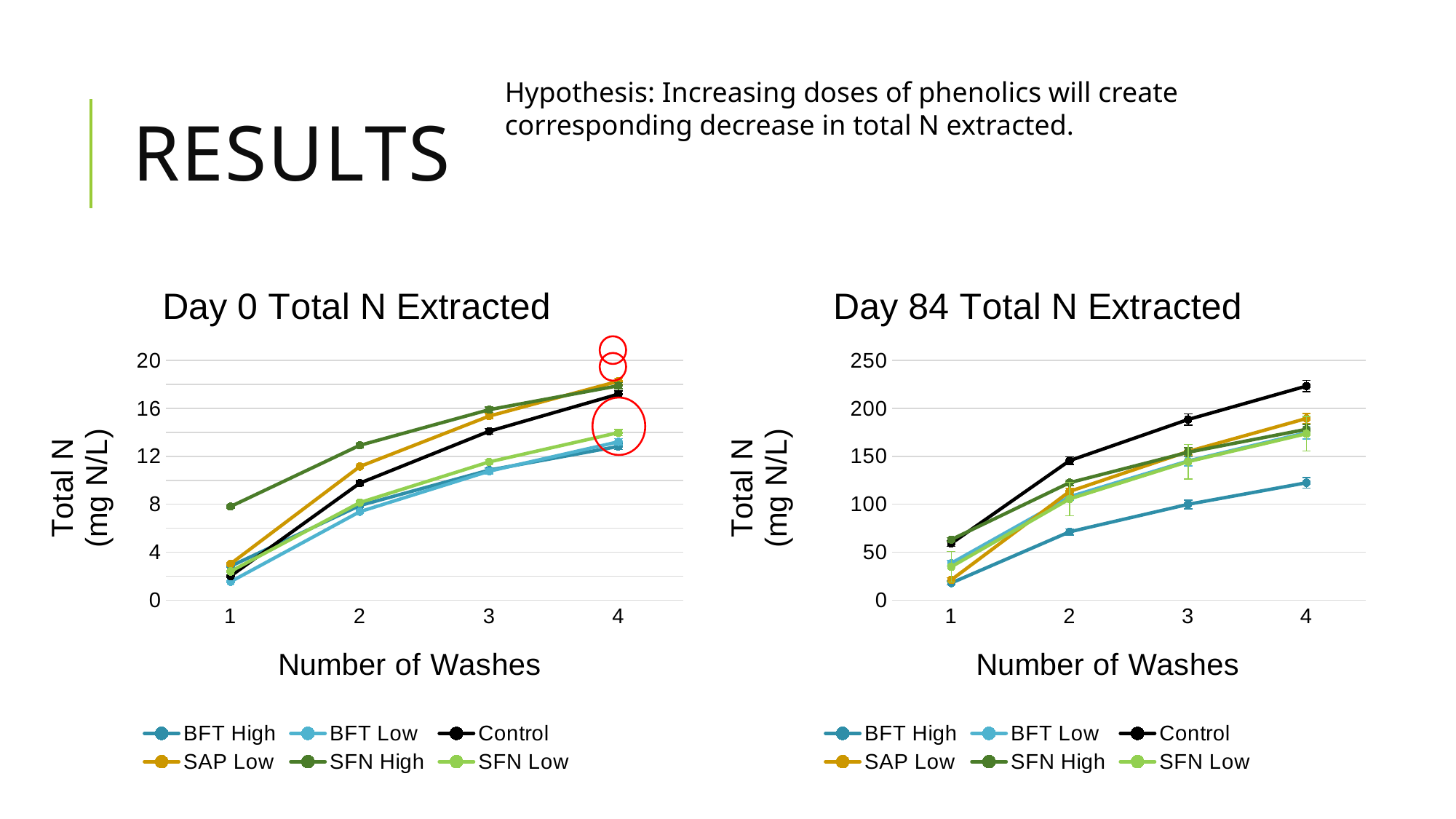
How many series does the legend of the Day 84 Total N Extracted chart list? 6 What kind of chart is the Day 0 Total N Extracted chart? line chart In the Day 84 Total N Extracted chart, which series is lowest at wash 4? BFT High In the Day 84 Total N Extracted chart, do the values for Control rise or fall as the number of washes increases? rise In the Day 84 Total N Extracted chart, which series is highest at wash 4? Control In the Day 84 Total N Extracted chart, is the value for BFT High at wash 2 greater or less than 100? less What is the x-axis label of the Day 0 Total N Extracted chart? Number of Washes How many wash numbers are plotted on the x axis of the Day 0 Total N Extracted chart? 4 In the Day 0 Total N Extracted chart, is the value for SFN High at wash 1 greater or less than 4? greater In the Day 84 Total N Extracted chart, is the value for Control at wash 4 greater or less than 200? greater In the Day 0 Total N Extracted chart, which series is highest at wash 1? SFN High